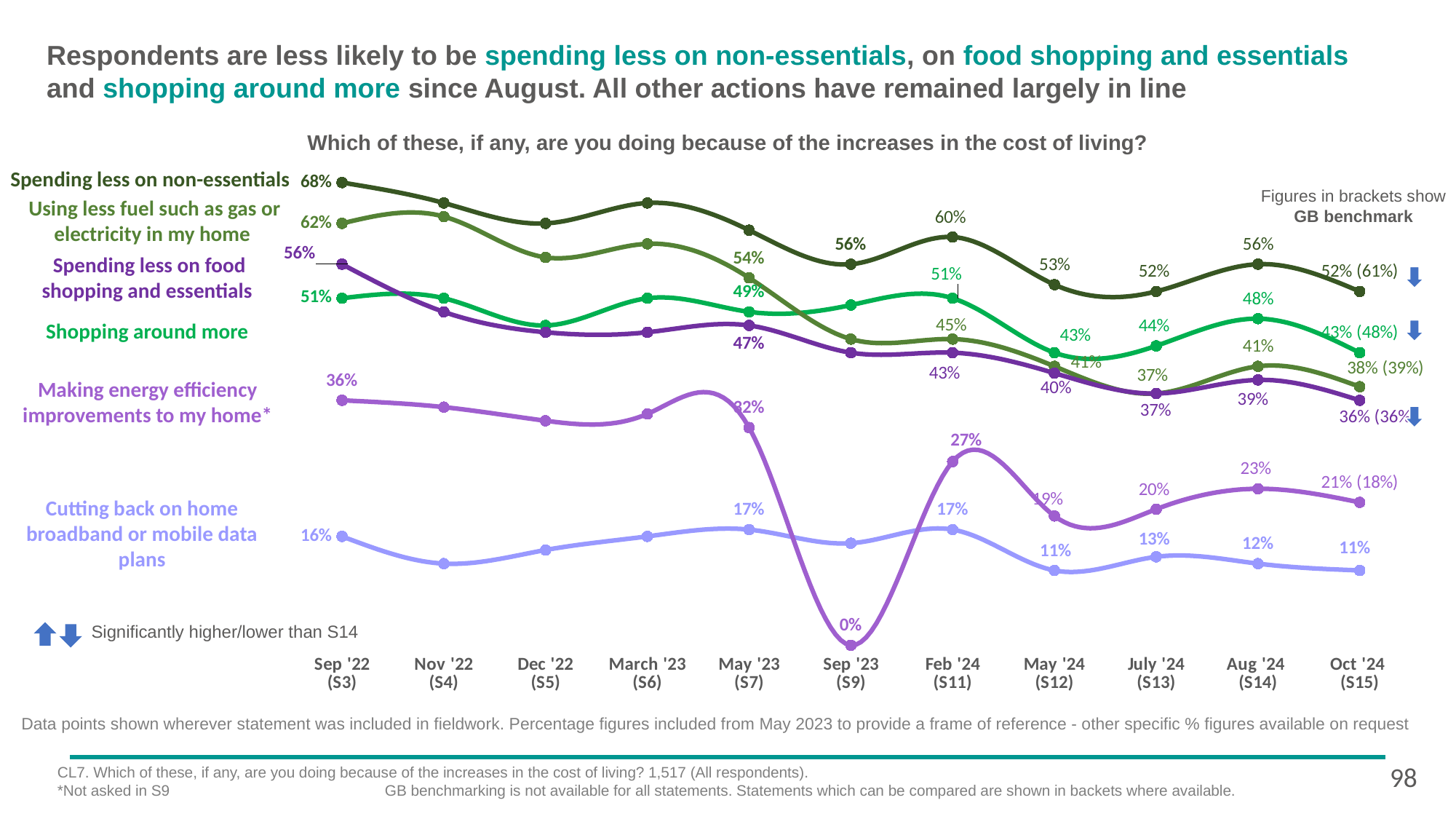
What is the difference between 'Making energy efficiency improvements to my home' in Feb '24 (27%) and May '24 (19%)? 8 percentage points Which action has the lowest value in Oct '24 (S15)? Cutting back on home broadband or mobile data plans What is the value for 'Spending less on non-essentials' in Oct '24 (S15)? 52% By how many percentage points did 'Spending less on non-essentials' fall between Sep '22 (68%) and Oct '24 (52%)? 16 percentage points How many survey waves (time points) are shown on the x axis? 11 What is the value for 'Making energy efficiency improvements to my home' in Sep '23 (S9)? 0% Which action has the highest value in Sep '22 (S3)? Spending less on non-essentials How many actions (series) are plotted on the chart? 6 In Aug '24 (S14), which is higher: 'Shopping around more' or 'Using less fuel such as gas or electricity in my home'? Shopping around more What is the value for 'Cutting back on home broadband or mobile data plans' in Feb '24 (S11)? 17% What type of chart is shown on the slide? Line chart What is the GB benchmark figure shown in brackets for 'Shopping around more' in Oct '24? 48%